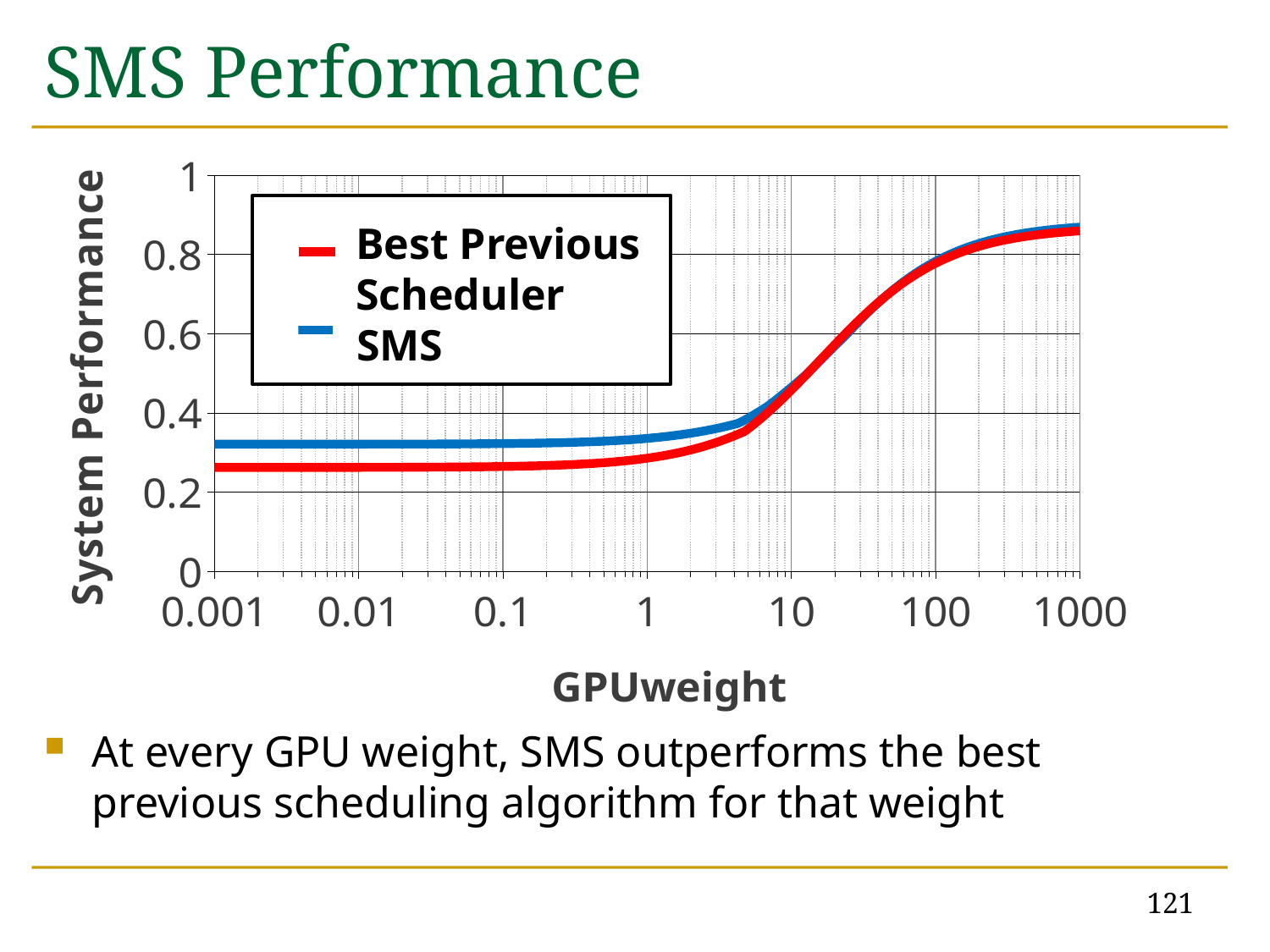
At a GPUweight of 0.001, which series has the lower System Performance, SMS or Best Previous Scheduler? Best Previous Scheduler Do the System Performance values rise or fall as GPUweight increases along the x axis? rise What is the title of the y axis? System Performance Is the System Performance of the Best Previous Scheduler at a GPUweight of 0.01 greater or less than 0.4? less Is the System Performance of the Best Previous Scheduler at a GPUweight of 1 greater or less than 0.6? less Is the System Performance of SMS at a GPUweight of 0.001 greater or less than 0.2? greater How many series does the legend list? 2 What kind of chart is shown on the slide? line chart What is the title of the x axis? GPUweight At a GPUweight of 0.1, which series has the higher System Performance, SMS or Best Previous Scheduler? SMS